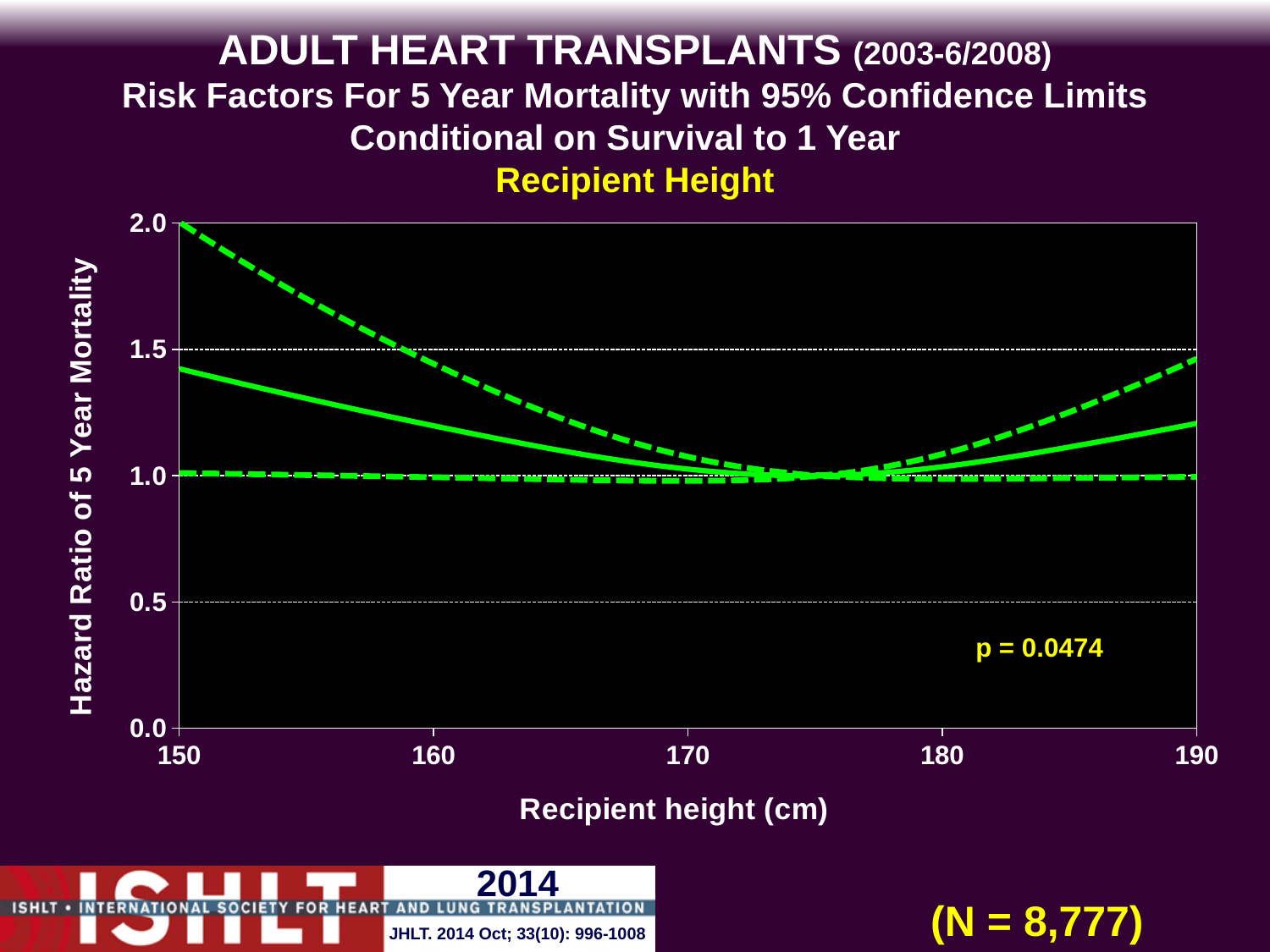
Does the hazard ratio (solid line) rise or fall as recipient height increases from 180 cm to 190 cm? rise Is the hazard ratio (solid line) at a recipient height of 190 cm greater or less than 1.0? greater Is the hazard ratio (solid line) at a recipient height of 150 cm greater or less than 1.5? less Is the hazard ratio (solid line) at a recipient height of 150 cm greater or less than 1.0? greater Does the hazard ratio (solid line) rise or fall as recipient height increases from 150 cm to 170 cm? fall What is the p-value printed on the chart? p = 0.0474 Is the hazard ratio (solid line) higher at a recipient height of 150 cm or at 190 cm? 150 cm What kind of chart is shown on the slide? line chart What is the sample size (N) shown on the slide? 8,777 How many lines are plotted on the chart? 3